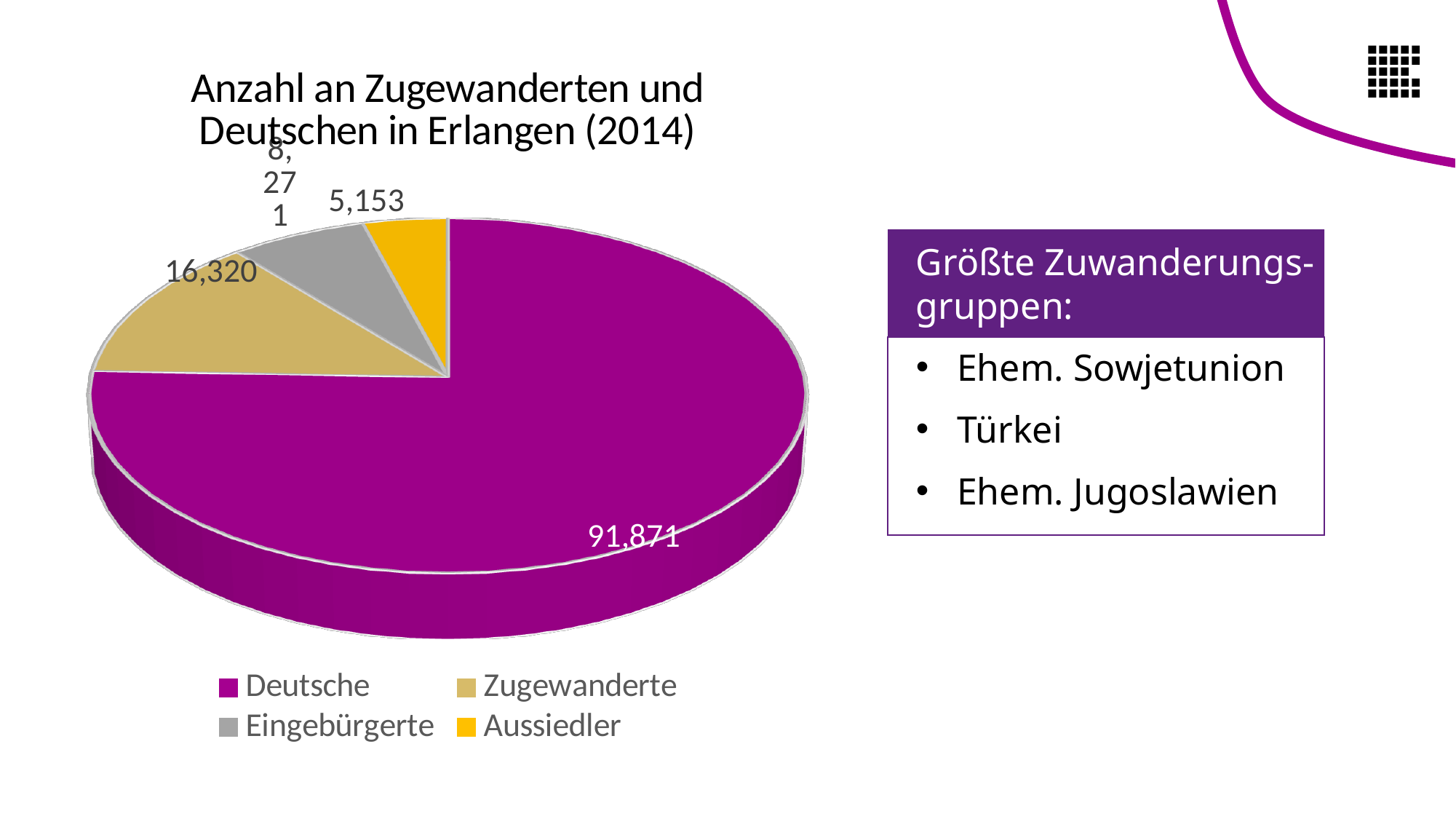
What type of chart is shown on the slide? Pie chart What is the difference between the values for Zugewanderte and Aussiedler? 11,167 Which is larger, the value for Zugewanderte or the value for Eingebürgerte? Zugewanderte Which category has the smallest slice in the pie chart? Aussiedler What is the value shown for Eingebürgerte in the pie chart? 8,271 Which category has the largest slice in the pie chart? Deutsche What is the value shown for Aussiedler in the pie chart? 5,153 What is the value shown for Deutsche in the pie chart? 91,871 What is the value shown for Zugewanderte in the pie chart? 16,320 What is the title of the chart? Anzahl an Zugewanderten und Deutschen in Erlangen (2014) How many categories does the pie chart show? 4 How much larger is the value for Deutsche than the value for Zugewanderte? 75,551